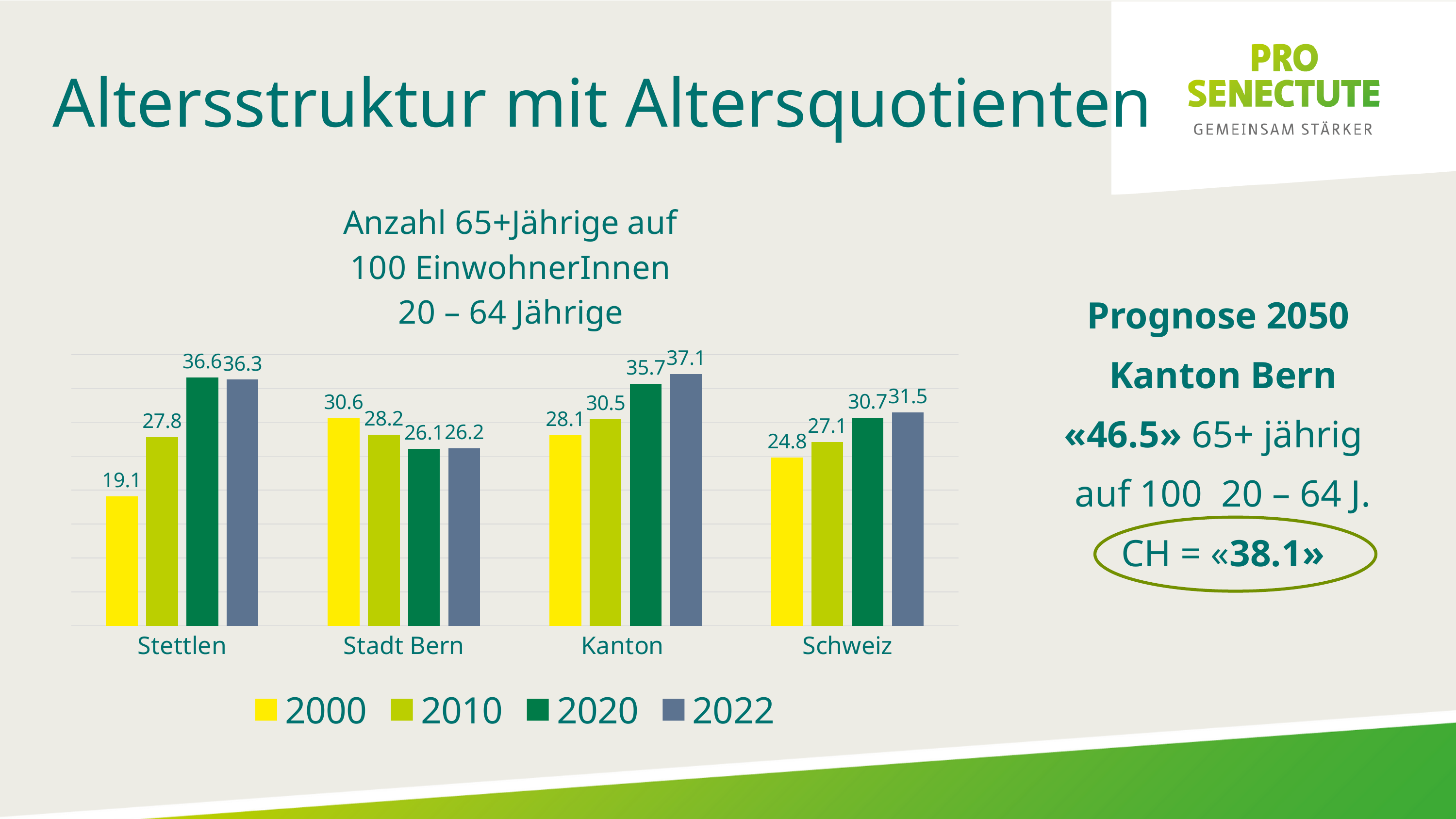
Do the values for Stadt Bern rise or fall from 2000 to 2020? Fall What is the difference between the 2022 values for Kanton and Schweiz? 5.6 How many categories are shown on the x axis? 4 How many series does the legend list? 4 What is the value for Kanton in 2022? 37.1 What is the value for Stettlen in 2000? 19.1 Which category has the highest value in the 2022 series? Kanton What is the difference between the 2020 and 2000 values for Stettlen? 17.5 What kind of chart is shown on the slide? Bar chart What is the value for Schweiz in 2010? 27.1 Which category has the lowest value in the 2000 series? Stettlen Which is larger for Stadt Bern: the 2000 value or the 2022 value? 2000